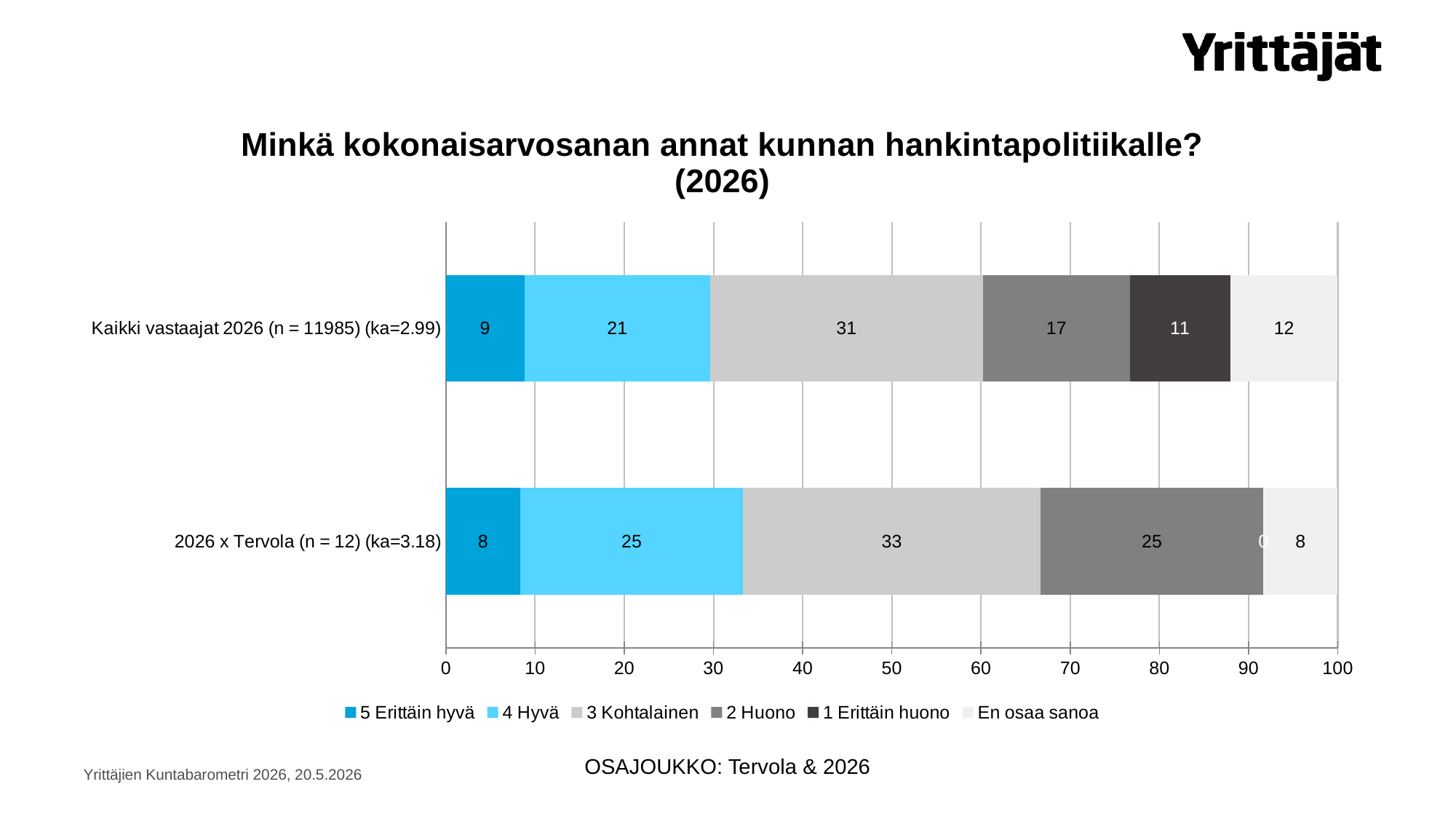
Which segment is the largest in the "2026 x Tervola (n = 12) (ka=3.18)" bar? 3 Kohtalainen What is the value of "3 Kohtalainen" for "Kaikki vastaajat 2026 (n = 11985) (ka=2.99)"? 31 Which category has the larger "2 Huono" value, "Kaikki vastaajat 2026 (n = 11985) (ka=2.99)" or "2026 x Tervola (n = 12) (ka=3.18)"? 2026 x Tervola (n = 12) (ka=3.18) How many series does the legend list? 6 What is the value of "2 Huono" for "2026 x Tervola (n = 12) (ka=3.18)"? 25 What is the title of the chart? Minkä kokonaisarvosanan annat kunnan hankintapolitiikalle? (2026) What kind of chart is shown on the slide? Stacked bar chart What is the value of "1 Erittäin huono" for "2026 x Tervola (n = 12) (ka=3.18)"? 0 What is the value of "En osaa sanoa" for "Kaikki vastaajat 2026 (n = 11985) (ka=2.99)"? 12 What is the difference between the "4 Hyvä" values for "2026 x Tervola (n = 12) (ka=3.18)" and "Kaikki vastaajat 2026 (n = 11985) (ka=2.99)"? 4 Which segment is the smallest in the "Kaikki vastaajat 2026 (n = 11985) (ka=2.99)" bar? 5 Erittäin hyvä How many categories (bars) are plotted in the chart? 2